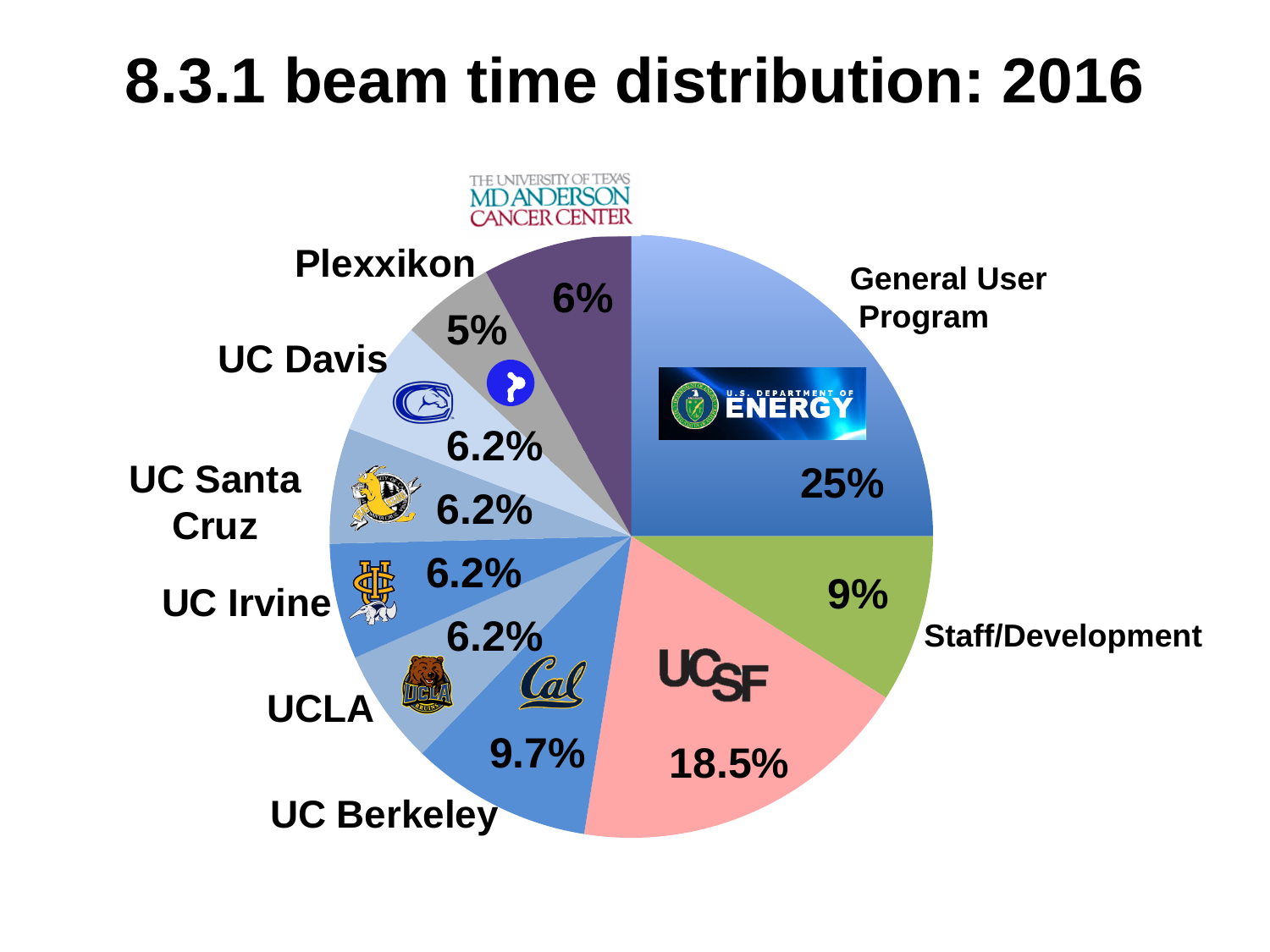
What percentage is shown for UCLA? 6.2% How many slices does the pie chart have? 10 Which slice has the smallest share of beam time? Plexxikon What percentage is shown for the UCSF slice? 18.5% What percentage is shown for Staff/Development? 9% What percentage is shown for Plexxikon? 5% What type of chart is shown on the slide? Pie chart Which slice has the largest share of beam time? General User Program What percentage of beam time is labelled for UC Berkeley? 9.7% How many percentage points larger is the General User Program share than the Staff/Development share? 16% What share of beam time does the General User Program slice show? 25% Which is larger, the UC Berkeley share or the Staff/Development share? UC Berkeley